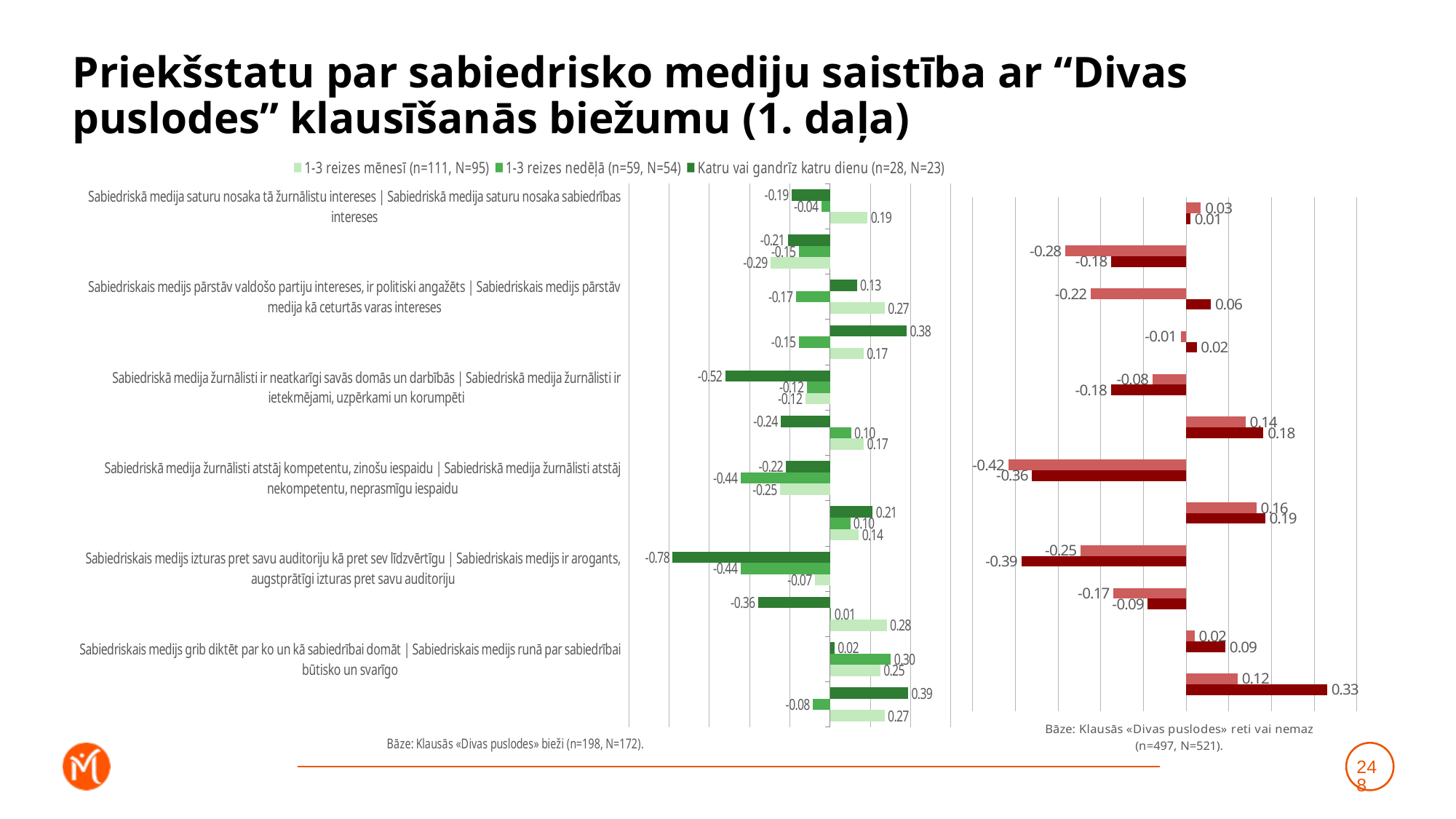
In the left (green) chart, what is the value for "1-3 reizes nedēļā" for the category "Sabiedriskais medijs pārstāv valdošo partiju intereses, ir politiski angažēts | Sabiedriskais medijs pārstāv medija kā ceturtās varas intereses"? -0.17 How many series does the legend of the left (green) chart list? 3 What is the lowest value shown in the right (red) chart? -0.42 In the left (green) chart, what is the value for "Katru vai gandrīz katru dienu" for the category "Sabiedriskais medijs izturas pret savu auditoriju kā pret sev līdzvērtīgu | Sabiedriskais medijs ir arogants, augstprātīgi izturas pret savu auditoriju"? -0.78 In the left (green) chart, what is the value for "Katru vai gandrīz katru dienu" for the category "Sabiedriskā medija saturu nosaka tā žurnālistu intereses | Sabiedriskā medija saturu nosaka sabiedrības intereses"? -0.19 What kind of chart is used on this slide? Bar chart In the left (green) chart, what is the value for "1-3 reizes mēnesī" for the category "Sabiedriskā medija saturu nosaka tā žurnālistu intereses | Sabiedriskā medija saturu nosaka sabiedrības intereses"? 0.19 In the left (green) chart, for the category "Sabiedriskā medija žurnālisti atstāj kompetentu, zinošu iespaidu | Sabiedriskā medija žurnālisti atstāj nekompetentu, neprasmīgu iespaidu", what is the difference between the "Katru vai gandrīz katru dienu" value (-0.22) and the "1-3 reizes nedēļā" value (-0.44)? 0.22 What is the lowest value shown in the left (green) chart? -0.78 In the left (green) chart, what is the value for "Katru vai gandrīz katru dienu" for the category "Sabiedriskā medija žurnālisti ir neatkarīgi savās domās un darbībās | Sabiedriskā medija žurnālisti ir ietekmējami, uzpērkami un korumpēti"? -0.52 In the left (green) chart, for the category "Sabiedriskais medijs grib diktēt par ko un kā sabiedrībai domāt | Sabiedriskais medijs runā par sabiedrībai būtisko un svarīgo", which is larger: the "1-3 reizes nedēļā" value or the "1-3 reizes mēnesī" value? 1-3 reizes nedēļā What is the highest value shown in the right (red) chart? 0.33